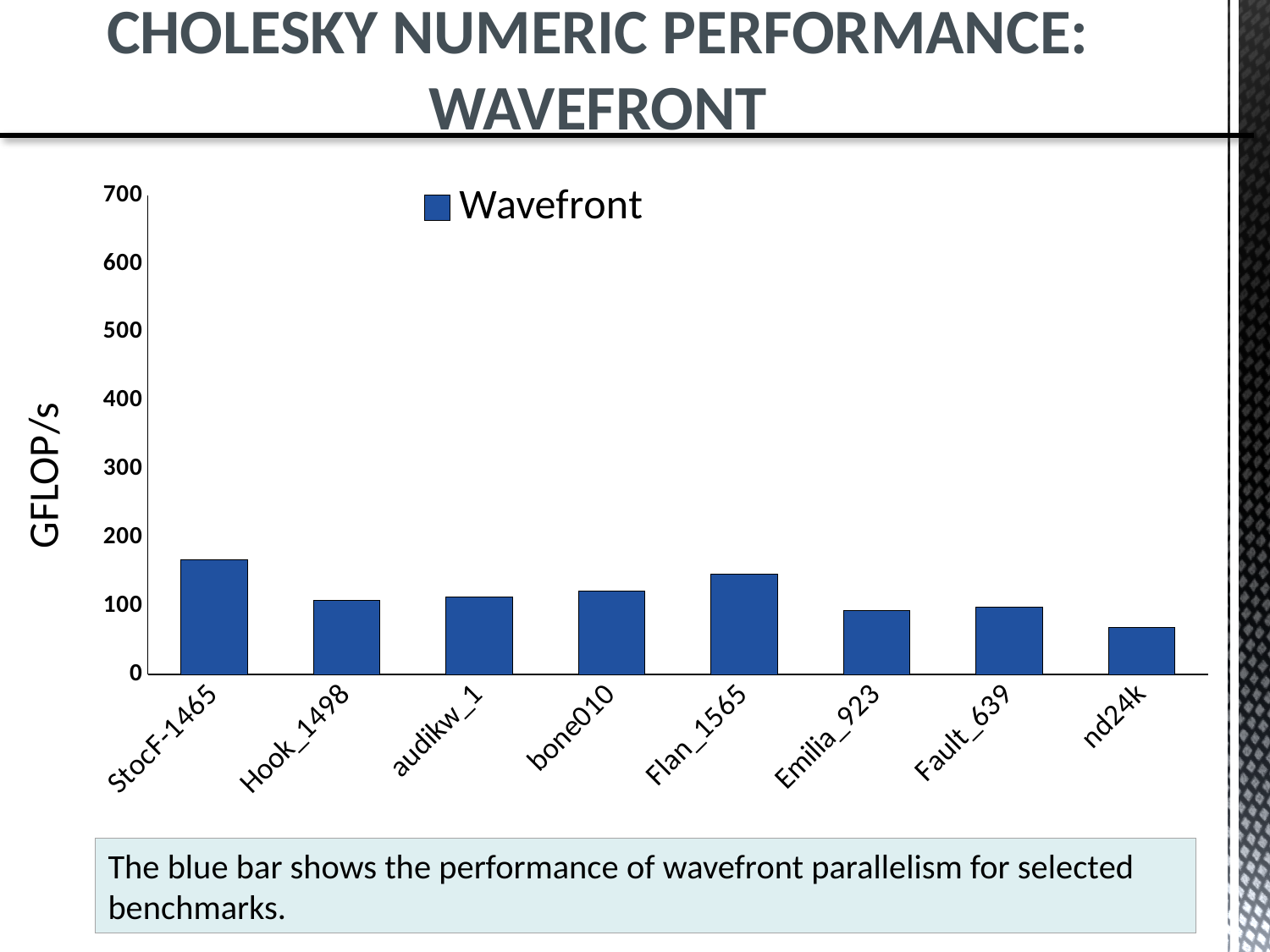
Is the value for Flan_1565 greater or less than 200? less Which benchmark has the highest Wavefront performance? StocF-1465 Is the value for nd24k greater or less than 100? less Which benchmark has the lowest Wavefront performance? nd24k What kind of chart is shown on the slide? bar chart What is the label on the y axis of the chart? GFLOP/s Is the value for StocF-1465 greater or less than 100? greater Which is larger, the value for bone010 or the value for Emilia_923? bone010 How many series does the legend list? 1 Which is larger, the value for StocF-1465 or the value for Flan_1565? StocF-1465 How many benchmarks are plotted along the x axis? 8